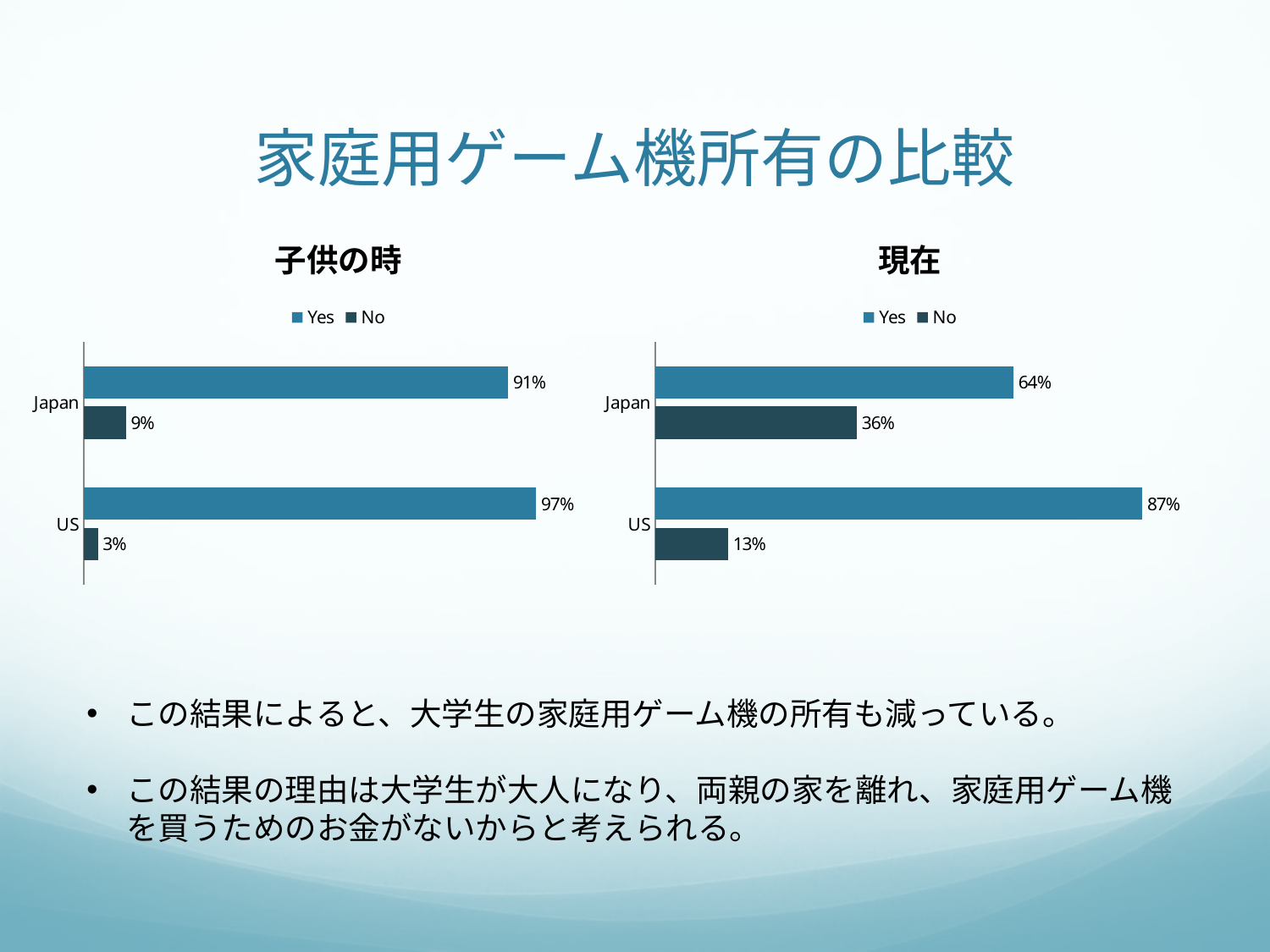
How many categories are shown in the left chart (子供の時)? 2 In the left chart (子供の時), is the Yes value for Japan larger or smaller than the Yes value for US? smaller In the right chart (現在), what is the difference between the Yes values for US and Japan? 23% What kind of chart is the left chart (子供の時)? bar chart What is the title of the right chart? 現在 In the left chart (子供の時), what is the Yes value for Japan? 91% In the right chart (現在), what is the No value for US? 13% In the left chart (子供の時), what is the No value for US? 3% How many series does the legend of the right chart (現在) list? 2 In the right chart (現在), what is the Yes value for Japan? 64% In the right chart (現在), which category has the higher Yes value? US In the left chart (子供の時), which category has the lower No value? US